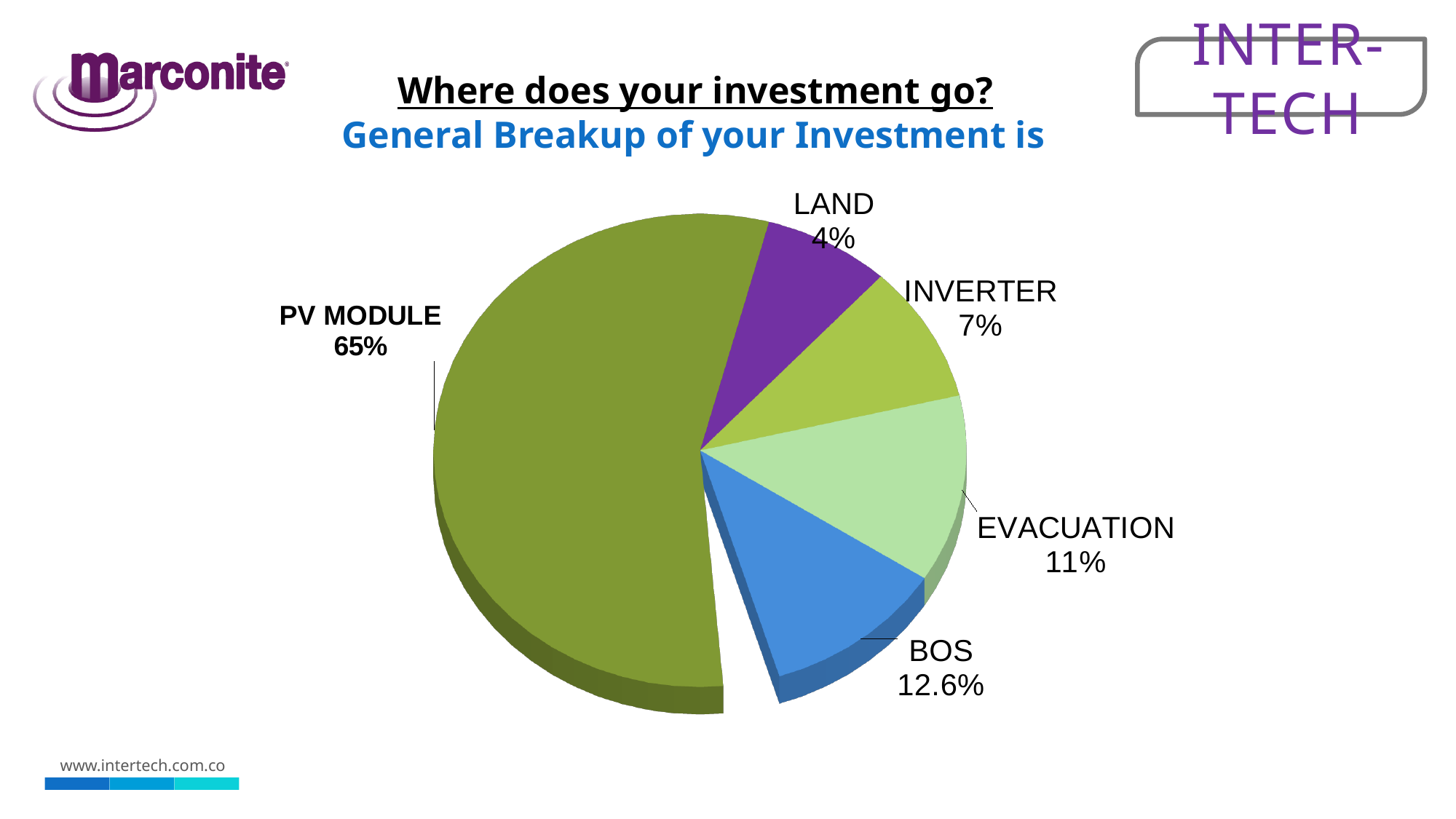
What colour is the PV MODULE slice? Olive green Which has a larger share, EVACUATION or INVERTER? EVACUATION What share of the investment goes to PV MODULE? 65% What share of the investment goes to LAND? 4% What share of the investment goes to INVERTER? 7% What is the difference between the PV MODULE share and the BOS share? 52.4% What share of the investment goes to EVACUATION? 11% Which category has the smallest share of the investment? LAND What share of the investment goes to BOS? 12.6% Which category has the largest share of the investment? PV MODULE What type of chart is shown on the slide? Pie chart